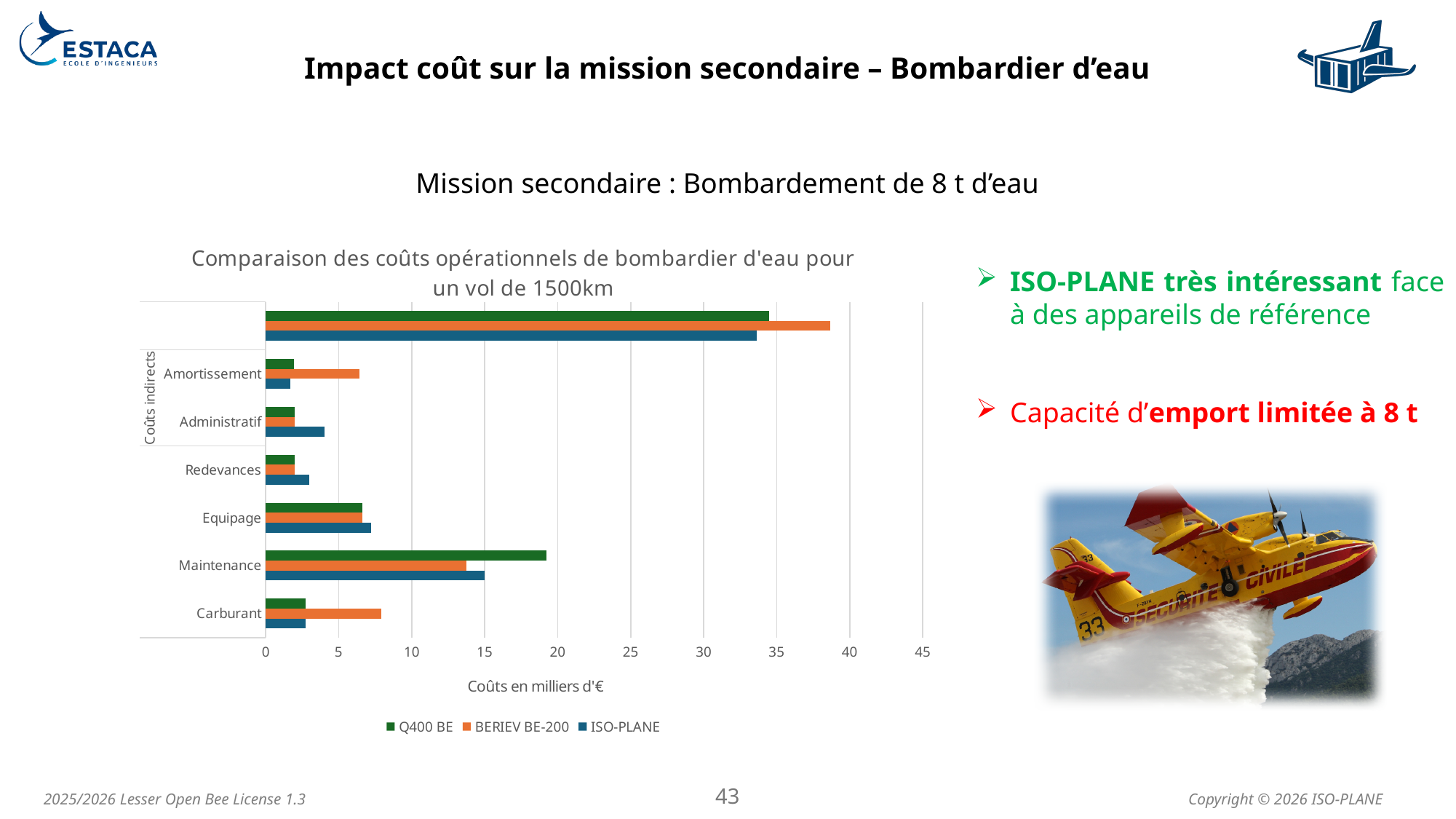
For Carburant, which is larger: the BERIEV BE-200 value or the ISO-PLANE value? BERIEV BE-200 Is the Carburant value for BERIEV BE-200 greater or less than 5? greater Is the Amortissement value for ISO-PLANE greater or less than 5? less What kind of chart is shown on the slide? Bar chart Is the Maintenance value for ISO-PLANE greater or less than 10? greater For Amortissement, which is larger: the BERIEV BE-200 value or the Q400 BE value? BERIEV BE-200 What is the title of the x axis of the chart? Coûts en milliers d'€ How many series does the chart legend list? 3 Which series are listed in the chart legend? Q400 BE, BERIEV BE-200, ISO-PLANE For Maintenance, which is larger: the Q400 BE value or the BERIEV BE-200 value? Q400 BE Among the labelled cost categories (Amortissement to Carburant), which has the highest Q400 BE value? Maintenance